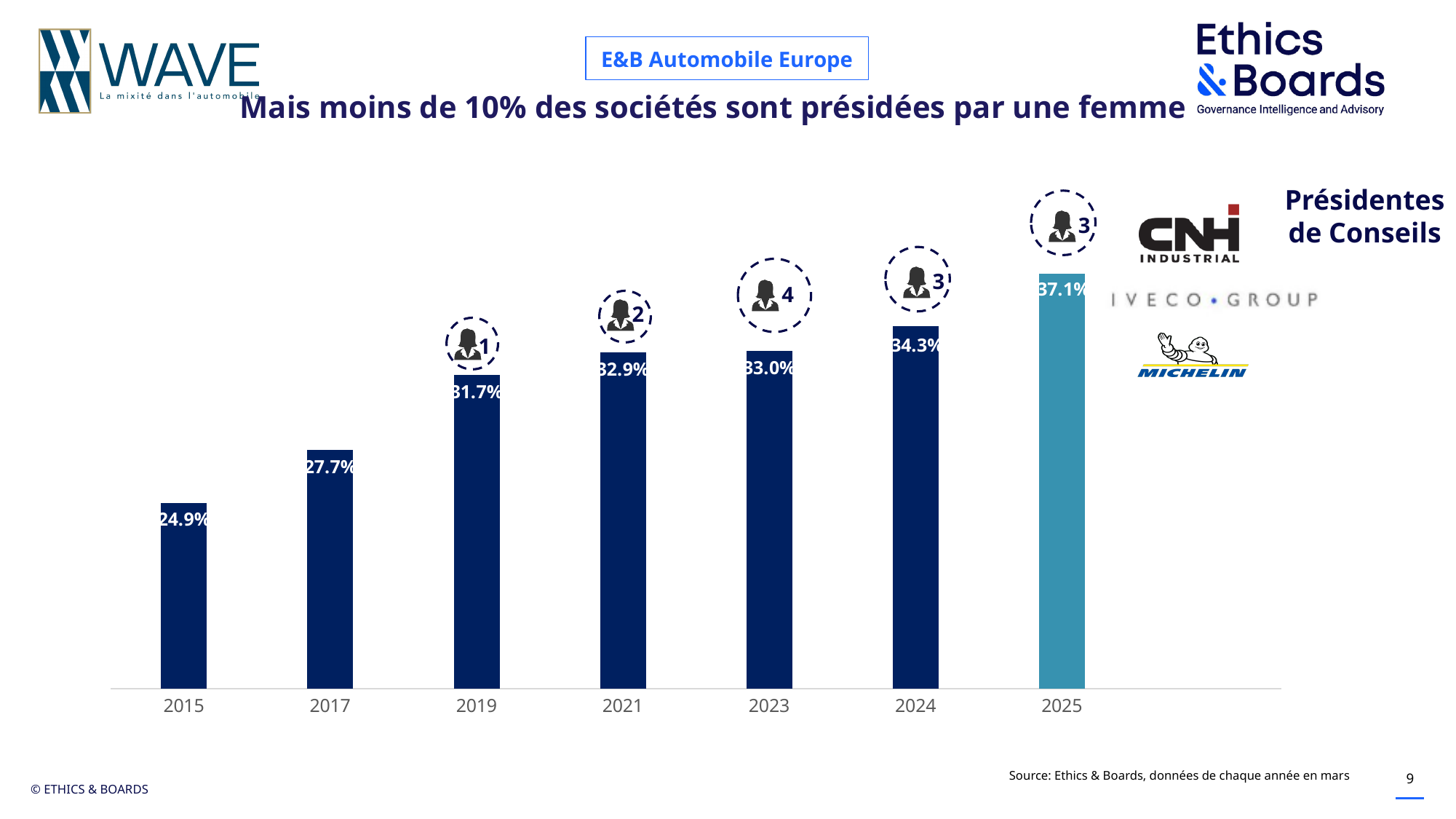
What is the value shown for 2021? 32.9% How many 'Présidentes de Conseils' are indicated above the 2023 bar? 4 Which year has the highest value? 2025 Do the values rise or fall from 2015 to 2025? Rise What is the difference between the values for 2025 and 2015? 12.2 percentage points How many years are shown on the x axis? 7 What is the value shown for 2015? 24.9% Which year has the lowest value? 2015 What is the value shown for 2025? 37.1% What kind of chart is shown on the slide? Bar chart Which is larger, the value for 2017 or the value for 2019? 2019 What is the difference between the values for 2024 and 2023? 1.3 percentage points